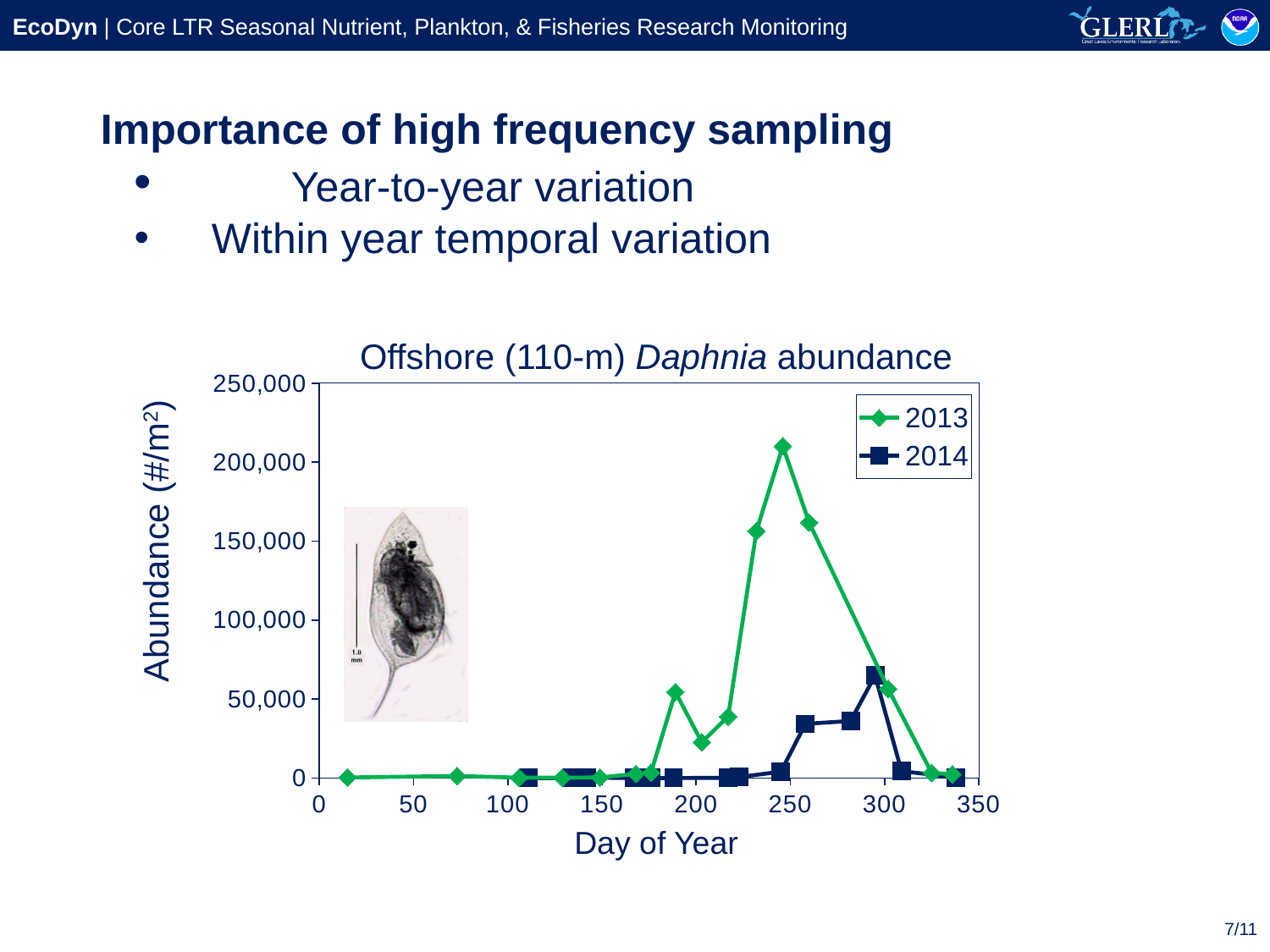
Is the peak value of the 2013 series greater or less than 200,000? greater What is the maximum value shown on the y axis? 250,000 How many series does the legend list? 2 Which years are listed in the chart legend? 2013 and 2014 Which series reaches the higher peak abundance, 2013 or 2014? 2013 What is the title of the chart? Offshore (110-m) Daphnia abundance Does the 2013 series rise or fall between day 250 and day 350? fall Is the peak value of the 2014 series greater or less than 50,000? greater Is the 2013 value at around day 190 greater or less than 100,000? less What kind of chart is shown on the slide? line chart